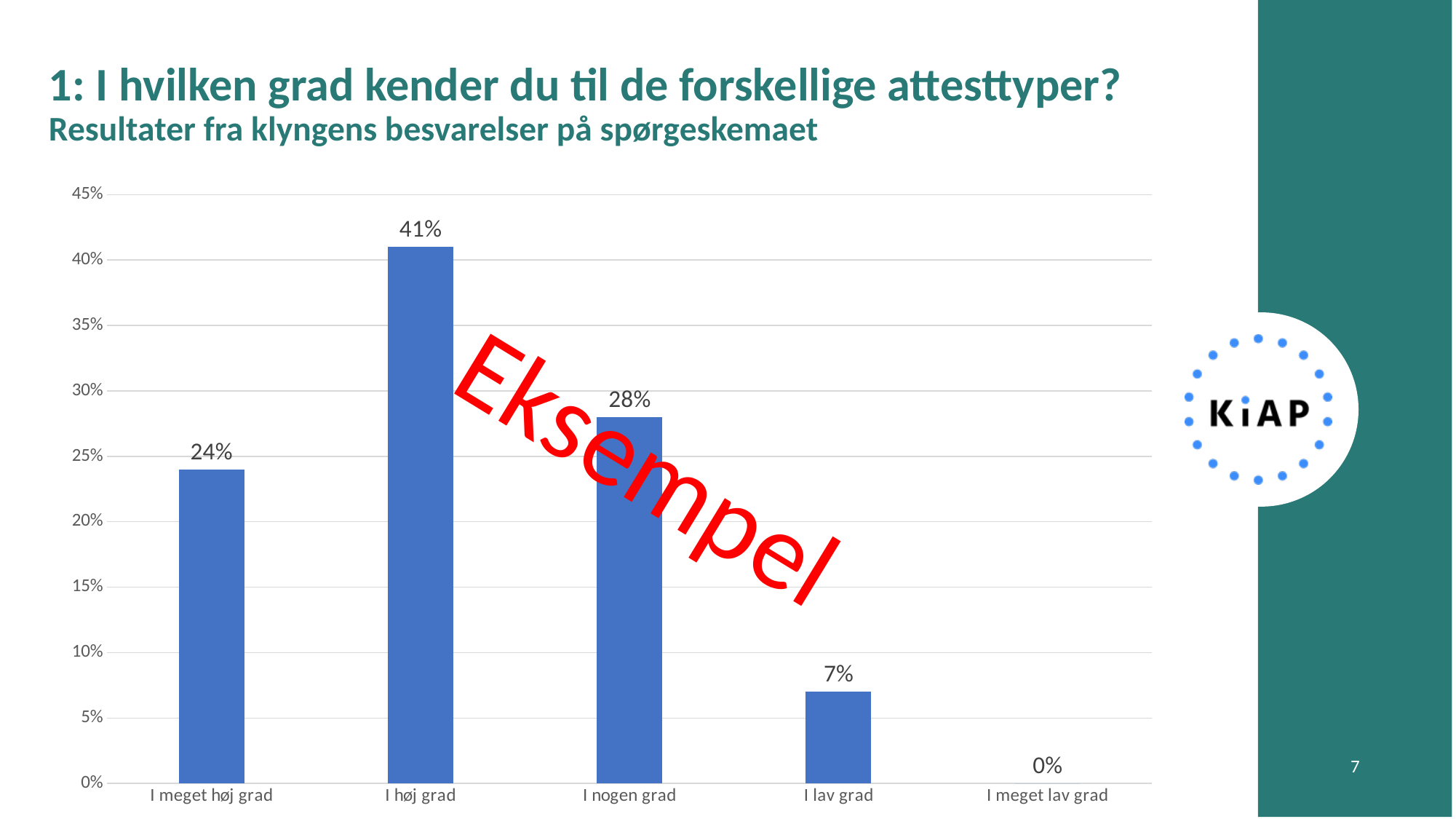
Which category has the lowest value? I meget lav grad What kind of chart is shown on the slide? bar chart What is the value for "I meget lav grad"? 0% Which category has the highest value? I høj grad What is the value for "I meget høj grad"? 24% Is the value for "I høj grad" greater or less than 40%? greater What is the difference between the values for "I høj grad" and "I nogen grad"? 13% Which is larger, the value for "I meget høj grad" or the value for "I nogen grad"? I nogen grad What is the value for "I høj grad"? 41% How many categories are shown on the x axis? 5 What is the highest value shown on the y axis? 45% What is the value for "I lav grad"? 7%